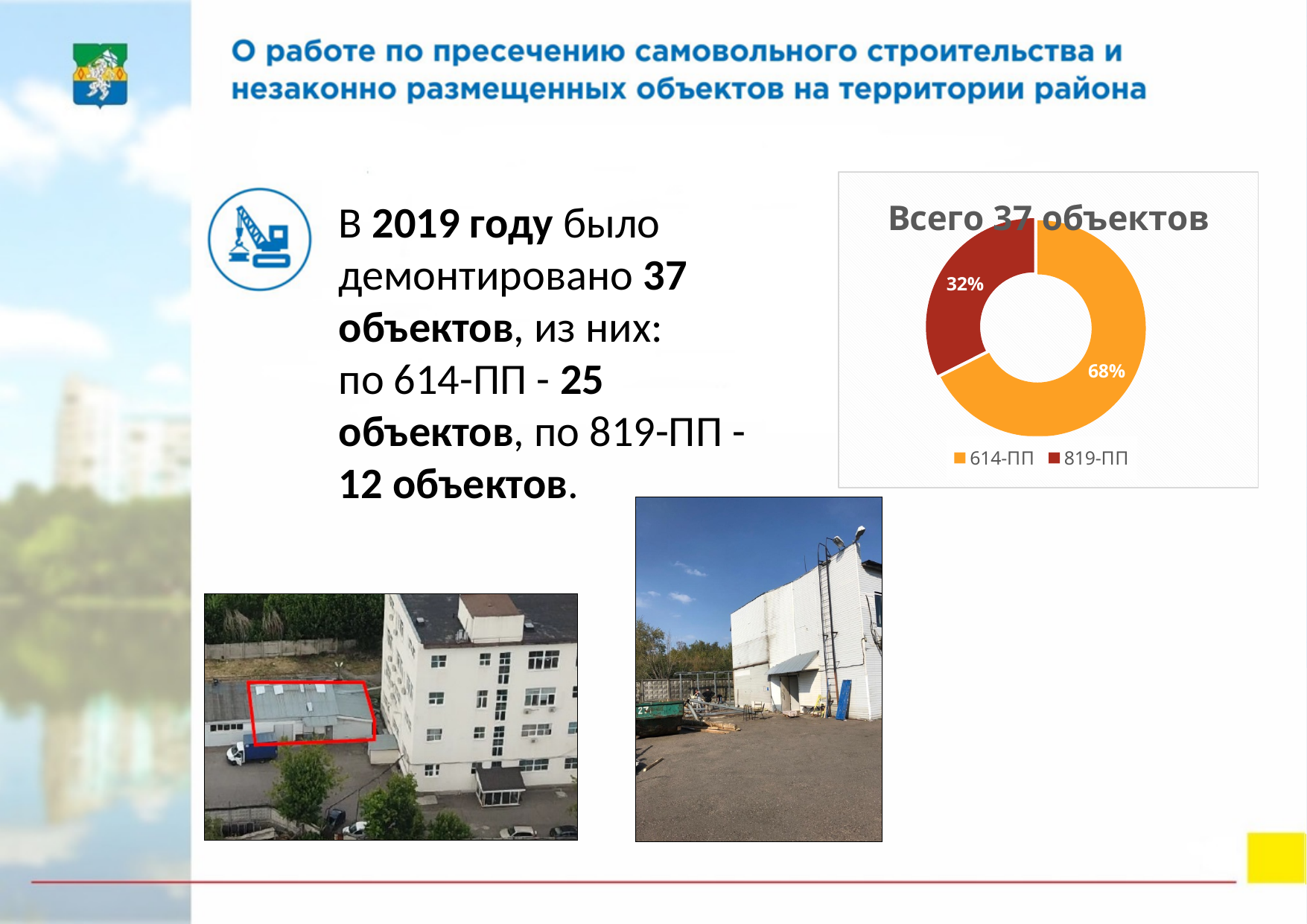
How many categories does the chart show? 2 Which category has the largest share in the chart? 614-ПП Is the share for 614-ПП greater or less than 50%? greater What is the title of the chart? Всего 37 объектов What share of the chart does 614-ПП represent? 68% What is the difference in percentage points between the 614-ПП and 819-ПП shares? 36 What share of the chart does 819-ПП represent? 32% Which is larger, the share for 614-ПП or the share for 819-ПП? 614-ПП How many entries does the chart legend list? 2 Which category has the smallest share in the chart? 819-ПП What kind of chart is shown on the slide? Doughnut (pie) chart Which colour represents 819-ПП in the chart? Dark red